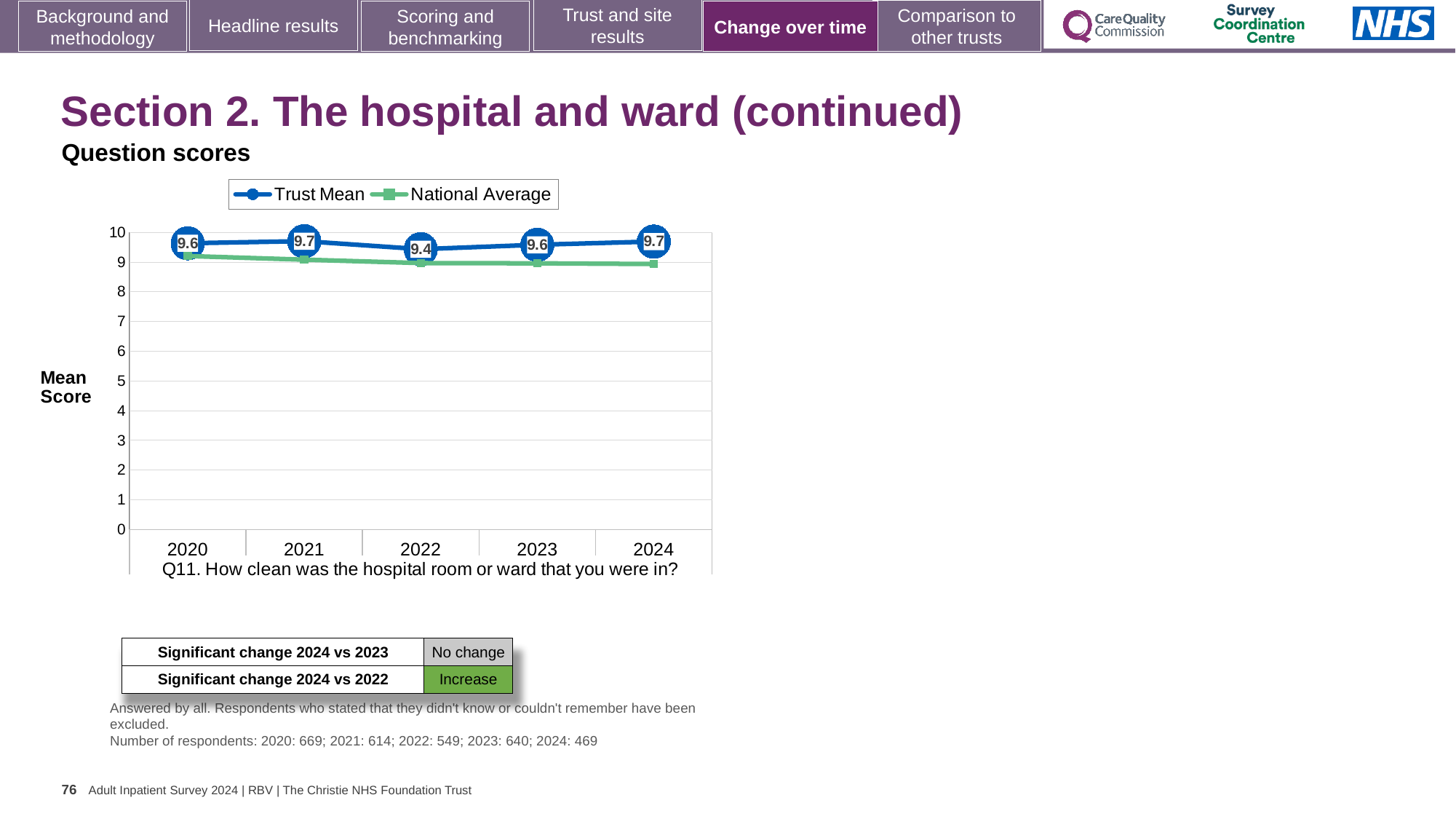
What is the label on the y axis of the chart? Mean Score Does the Trust Mean rise or fall from 2022 to 2024? Rise What kind of chart is shown on the slide? Line chart How many years are shown on the x axis? 5 What is the Trust Mean value for 2022? 9.4 What is the difference between the Trust Mean in 2024 and in 2022? 0.3 In which year is the Trust Mean lowest? 2022 What is the Trust Mean value for 2020? 9.6 Is the National Average value for 2020 greater or less than 8? greater What is the Trust Mean value for 2024? 9.7 How many series does the legend list? 2 Which is larger in 2022, the Trust Mean or the National Average? Trust Mean